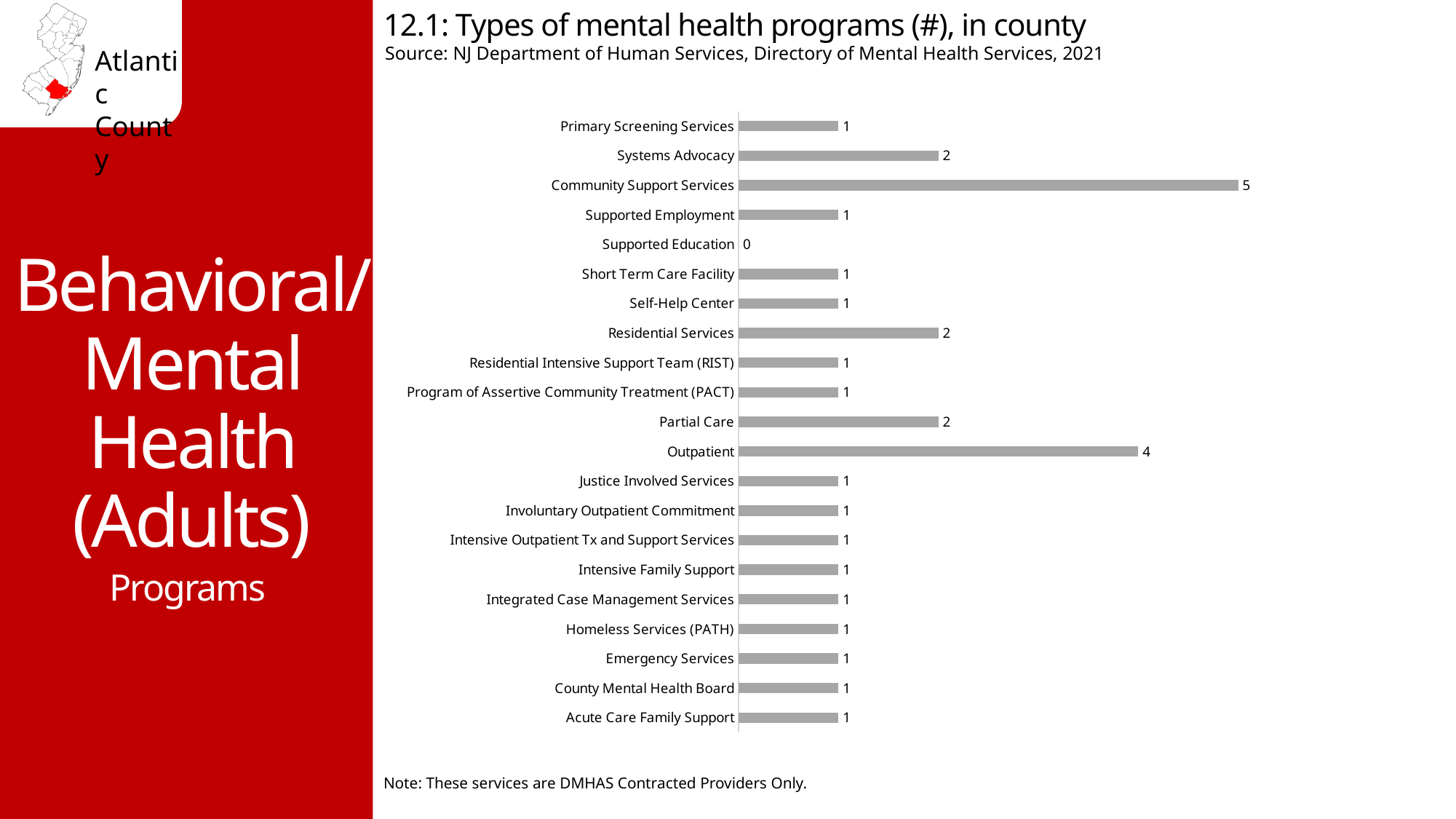
Which type of mental health program has the lowest count? Supported Education What is the source of the chart data? NJ Department of Human Services, Directory of Mental Health Services, 2021 What value is shown for Supported Education? 0 How many program types are listed on the chart? 21 Which type of mental health program has the highest count? Community Support Services How many Outpatient programs are shown on the chart? 4 What is the title of the chart? 12.1: Types of mental health programs (#), in county Which has more programs, Systems Advocacy or Primary Screening Services? Systems Advocacy What kind of chart is used to show the types of mental health programs? Bar chart What is the difference between the number of Community Support Services programs and Outpatient programs? 1 What is the value for Partial Care? 2 What is the number of Community Support Services programs in the county? 5